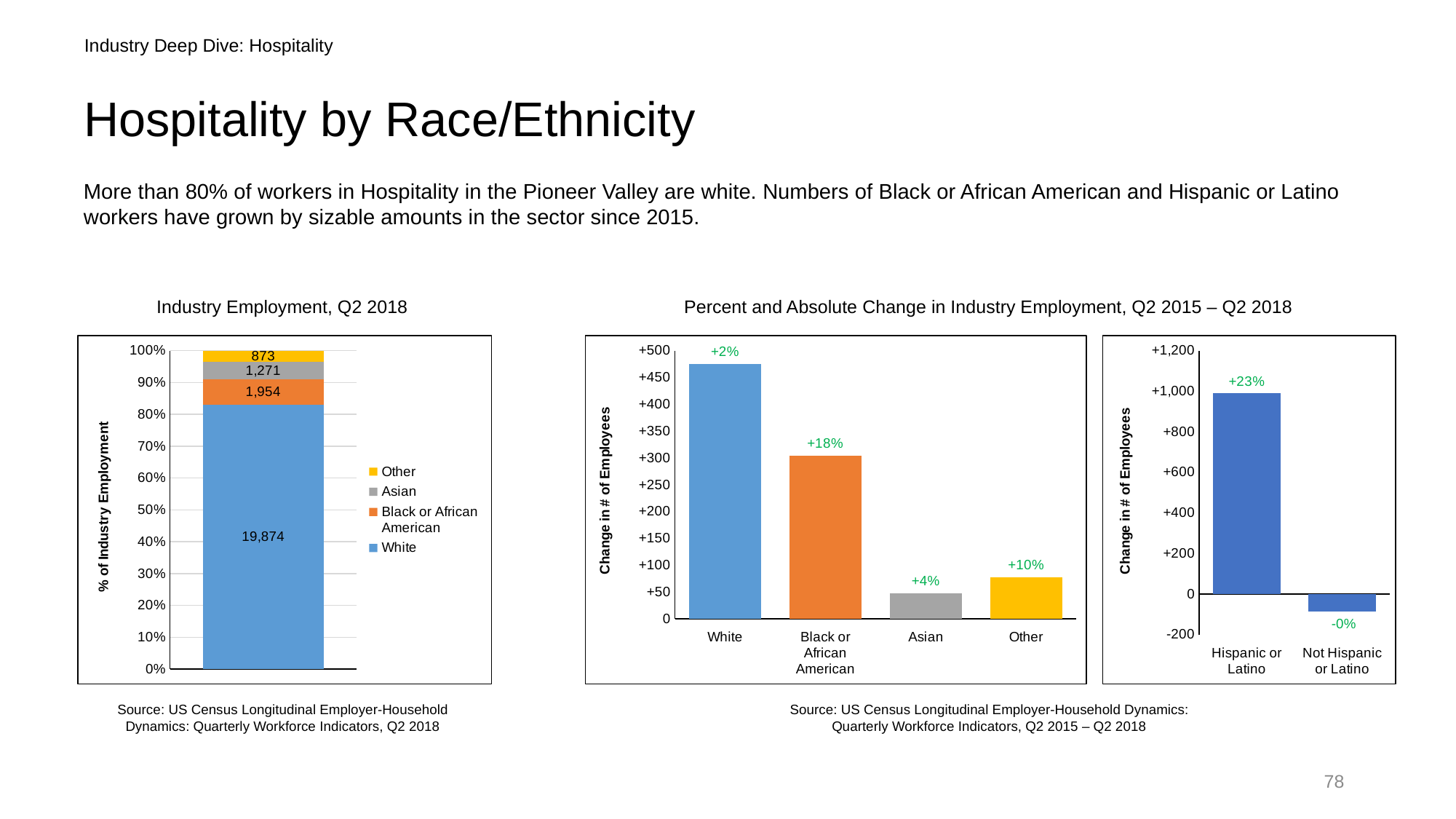
What kind of chart is the Industry Employment, Q2 2018 chart? Stacked bar chart How many series does the legend of the Industry Employment, Q2 2018 chart list? 4 In the middle chart (Percent and Absolute Change in Industry Employment by race), which category has the largest change in number of employees? White In the Industry Employment, Q2 2018 chart, what value is shown for the White segment? 19,874 In the rightmost chart (change in employment by Hispanic or Latino status), is the change in number of employees for Hispanic or Latino greater or less than +800? greater In the middle chart (Percent and Absolute Change in Industry Employment by race), is the change in number of employees for White greater or less than +400? greater In the rightmost chart (change in employment by Hispanic or Latino status), what percent change is labelled for Hispanic or Latino? +23% In the Industry Employment, Q2 2018 chart, what value is shown for the Asian segment? 1,271 In the Industry Employment, Q2 2018 chart, what is the total of all four segments of the stacked bar? 23,972 In the middle chart (Percent and Absolute Change in Industry Employment by race), what percent change is labelled for Black or African American? +18% In the middle chart (Percent and Absolute Change in Industry Employment by race), which category has the smallest change in number of employees? Asian In the Industry Employment, Q2 2018 chart, what is the difference between the Black or African American segment and the Asian segment? 683